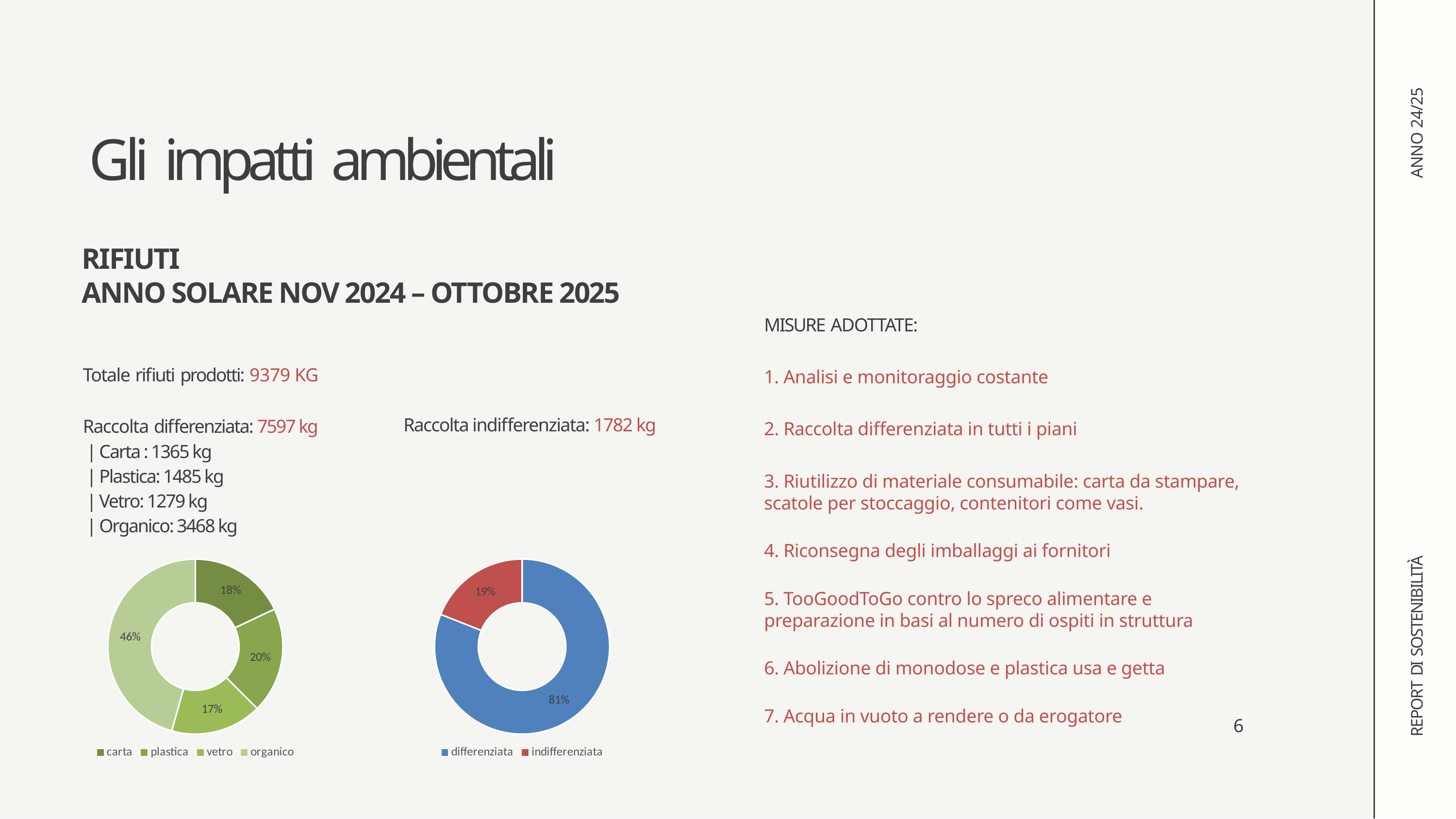
In the left doughnut chart, what percentage is shown for plastica? 20% In the left doughnut chart, what percentage is shown for organico? 46% In the left doughnut chart, how many categories does the legend list? 4 In the left doughnut chart, which category has the smallest share? vetro In the left doughnut chart, which category has the largest share? organico What type of chart is the right chart on the slide? doughnut chart In the right doughnut chart, what percentage is shown for differenziata? 81% In the right doughnut chart, what colour is the differenziata slice? blue In the left doughnut chart, what percentage is shown for vetro? 17% In the left doughnut chart, what is the difference in percentage points between organico and carta? 28 In the right doughnut chart, which is larger, differenziata or indifferenziata? differenziata In the right doughnut chart, what percentage is shown for indifferenziata? 19%